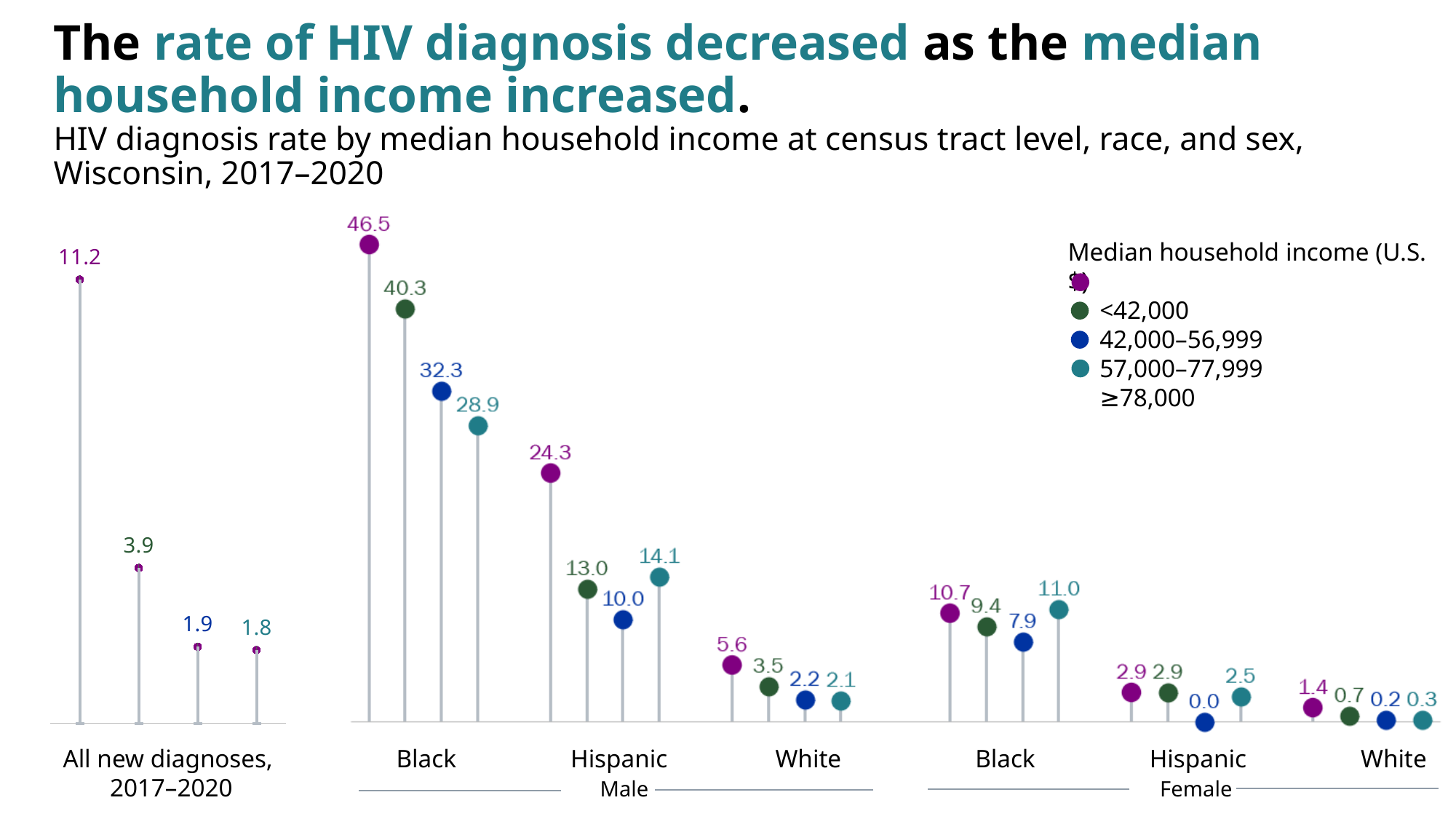
How many points are plotted in the 'All new diagnoses, 2017–2020' chart? 4 What is the difference between the highest (46.5) and lowest (28.9) values for Black males? 17.6 What is the sum of the four values plotted for Black females? 39.0 What state and years does the chart subtitle say the data cover? Wisconsin, 2017–2020 What is the value of the blue point for Hispanic females? 0.0 Which is larger: the purple point for Hispanic males or the teal point for Black females? Hispanic males (24.3) How many median household income groups does the legend list? 4 What is the highest HIV diagnosis rate shown for Black males (the leftmost point in that group)? 46.5 Do the values in the 'All new diagnoses, 2017–2020' chart rise or fall from left to right? fall What is the value of the teal (rightmost) point for Hispanic males? 14.1 In the 'All new diagnoses, 2017–2020' chart, what is the value of the first (leftmost) point? 11.2 Which race and sex group contains the highest HIV diagnosis rate on the slide? Black male